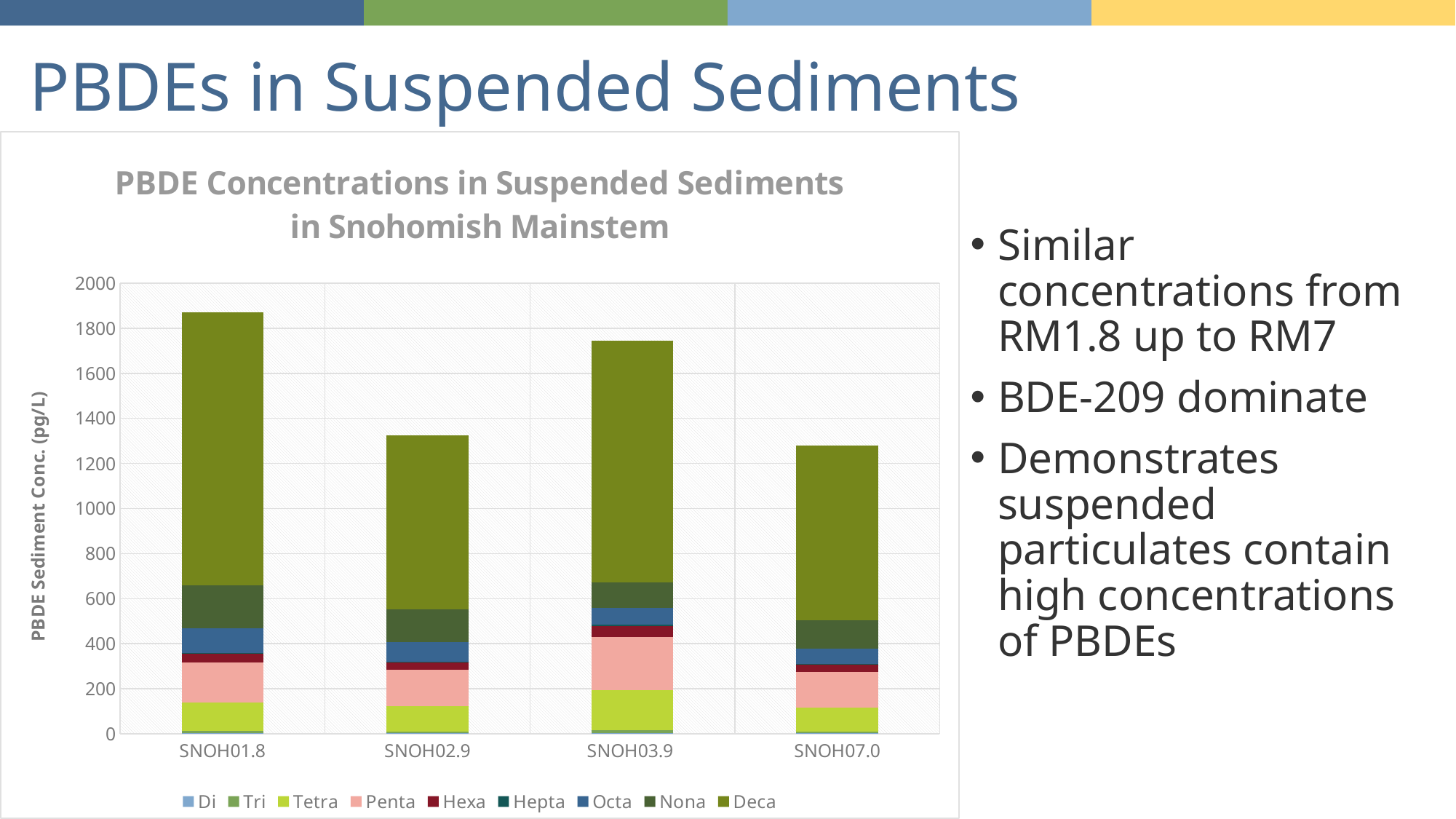
Which site has a larger total PBDE concentration, SNOH02.9 or SNOH03.9? SNOH03.9 What kind of chart is shown on the slide? Stacked bar chart How many series does the legend list? 9 Is the total PBDE concentration for SNOH01.8 greater or less than 1800? greater Which series makes up the largest portion of each stacked bar? Deca What is the label of the y axis? PBDE Sediment Conc. (pg/L) Is the total PBDE concentration for SNOH07.0 greater or less than 1400? less How many sampling sites (categories) are shown on the x axis? 4 Which site has the highest total PBDE sediment concentration? SNOH01.8 Is the total PBDE concentration for SNOH03.9 greater or less than 1600? greater Which site has a larger total PBDE concentration, SNOH01.8 or SNOH03.9? SNOH01.8